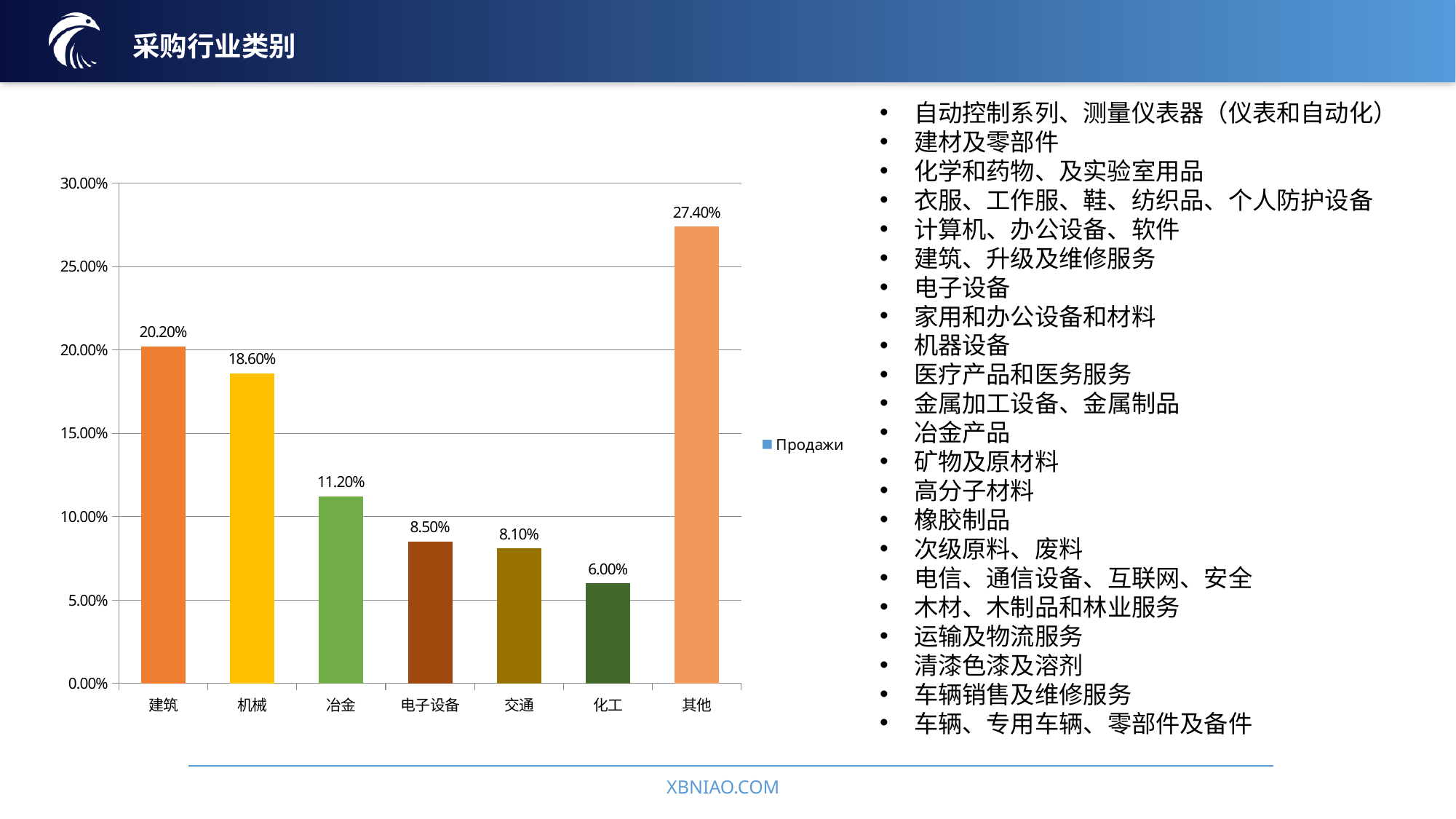
How many series does the legend list? 1 What is the value for 建筑? 20.20% What is the difference between the values for 其他 and 建筑? 7.20% What is the legend entry for the series? Продажи Which category has the highest value? 其他 What is the value for 机械? 18.60% What kind of chart is shown on the slide? bar chart Which category has the lowest value? 化工 Is the value for 交通 greater or less than 10.00%? less What is the value for 化工? 6.00% How many categories are shown on the x axis? 7 Which is larger, the value for 冶金 or the value for 电子设备? 冶金